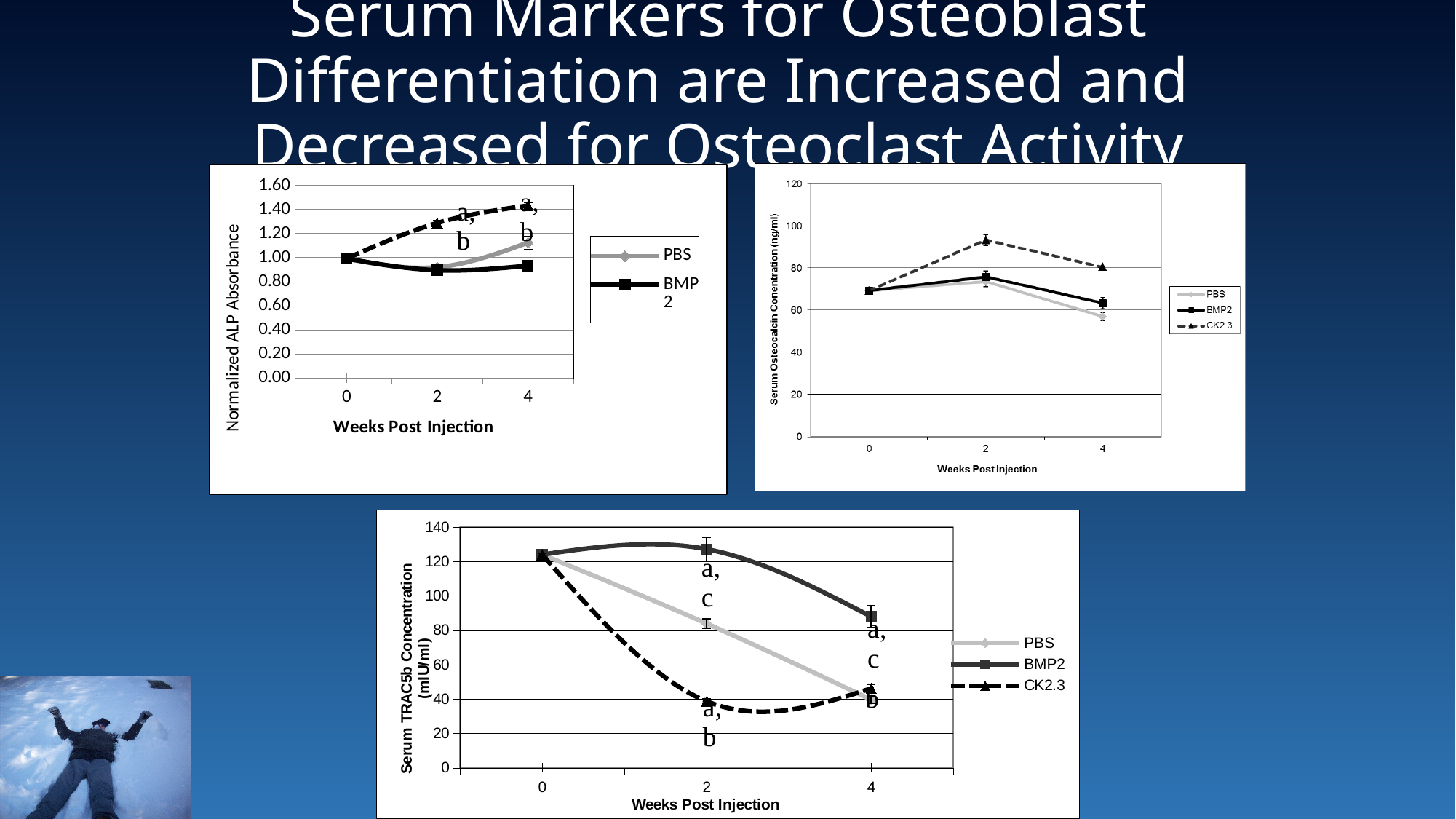
How many series does the legend of the top-right Serum Osteocalcin chart list? 3 In the bottom Serum TRAC5b chart, which series has the highest value at week 4? BMP2 In the top-right Serum Osteocalcin chart, which series has the lowest value at week 4? PBS In the bottom Serum TRAC5b chart, is the value for BMP2 at week 2 greater or less than 100? greater What is the x-axis title of the bottom Serum TRAC5b chart? Weeks Post Injection In the bottom Serum TRAC5b Concentration chart, how many time points are plotted along the x axis? 3 In the top-right Serum Osteocalcin chart, is the value for CK2.3 at week 2 greater or less than 80? greater What kind of chart is the top-left chart showing Normalized ALP Absorbance? line chart In the bottom Serum TRAC5b chart, is the value for CK2.3 at week 2 greater or less than 60? less How many series does the legend of the top-left ALP Absorbance chart list? 2 In the bottom Serum TRAC5b chart, does the PBS series rise or fall from week 0 to week 4? fall